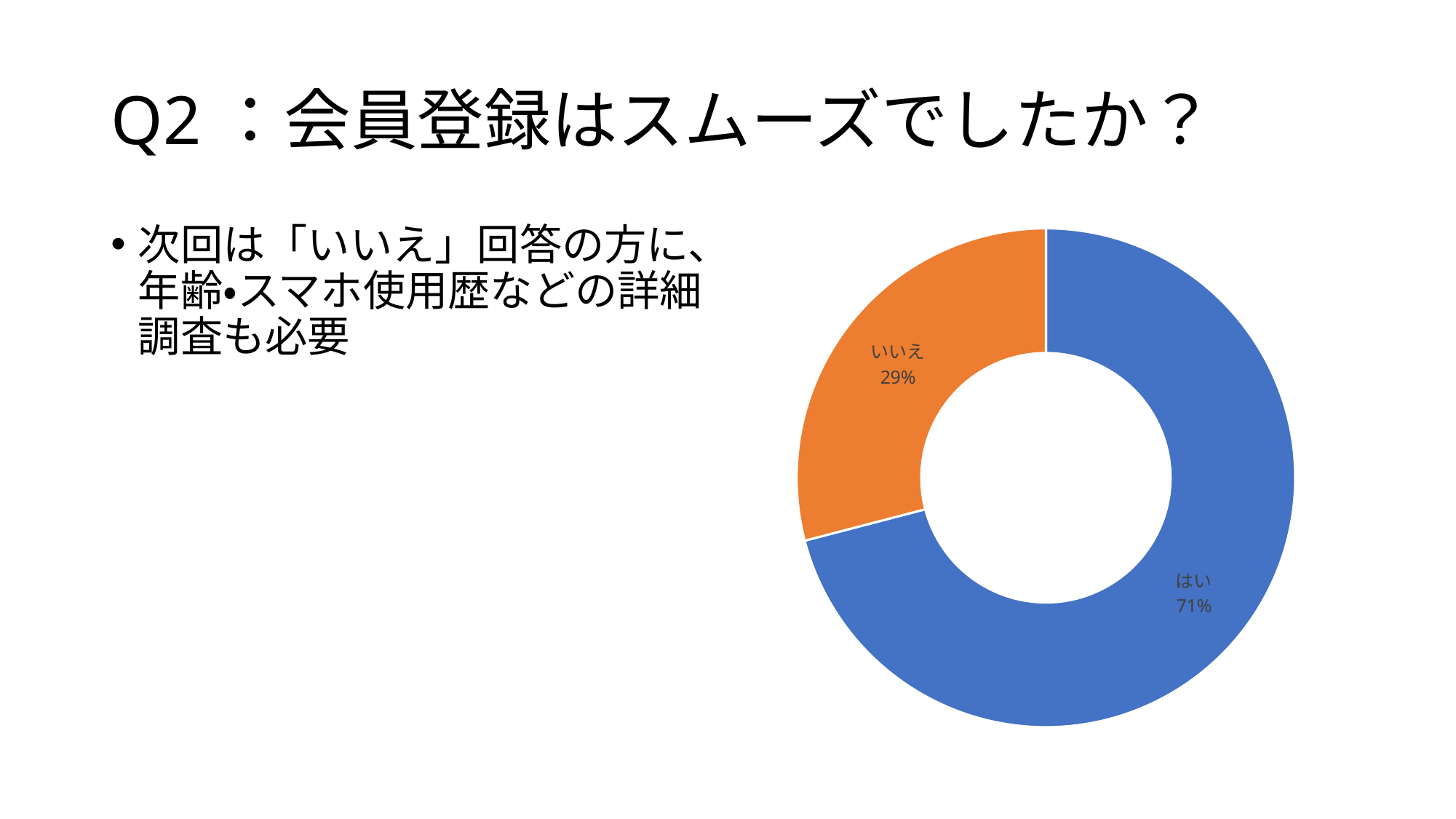
What kind of chart is shown on the slide? Doughnut chart Which is larger, the share for はい or the share for いいえ? はい What colour is the いいえ segment of the chart? Orange Which response has the largest share of the chart? はい Which response has the smallest share of the chart? いいえ What colour is the はい segment of the chart? Blue What is the difference in percentage points between the はい and いいえ shares? 42 What percentage of respondents answered いいえ? 29% What percentage of respondents answered はい? 71% What share of the chart does the いいえ slice represent? 29% How many categories are shown in the chart? 2